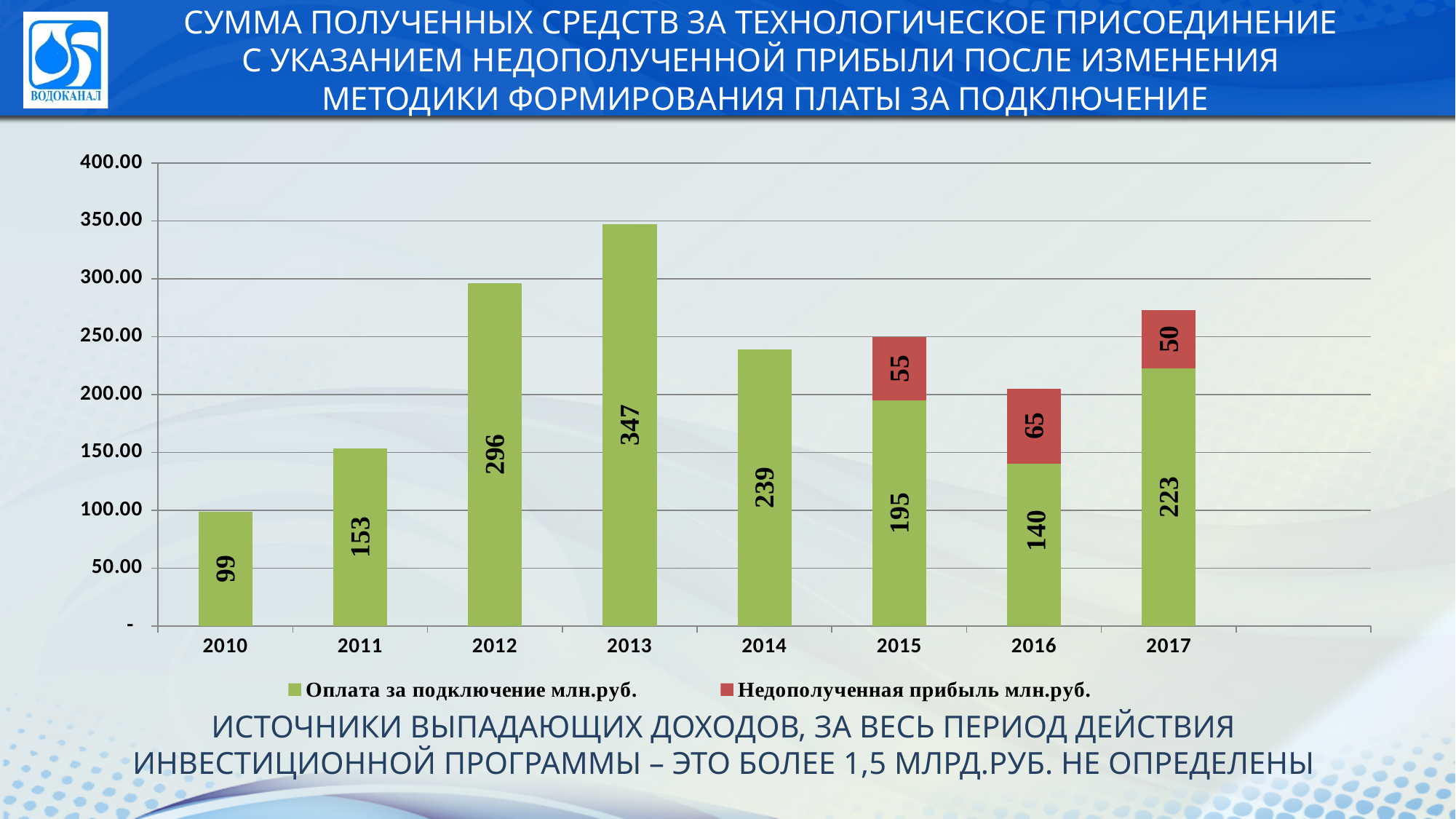
What kind of chart is shown on the slide? Stacked bar chart What is the difference between the "Оплата за подключение млн.руб." values for 2012 and 2011? 143 How many years are shown on the x axis? 8 Which year has the lowest value for "Оплата за подключение млн.руб."? 2010 How many series does the legend list? 2 What is the value of "Оплата за подключение млн.руб." for 2013? 347 What is the total of the stacked bar for 2015? 250 What is the value of "Недополученная прибыль млн.руб." for 2016? 65 Which is larger: the "Оплата за подключение млн.руб." value for 2014 or for 2017? 2014 Which year has the highest value for "Оплата за подключение млн.руб."? 2013 What is the value of "Оплата за подключение млн.руб." for 2010? 99 What is the total of the stacked bar for 2017? 273